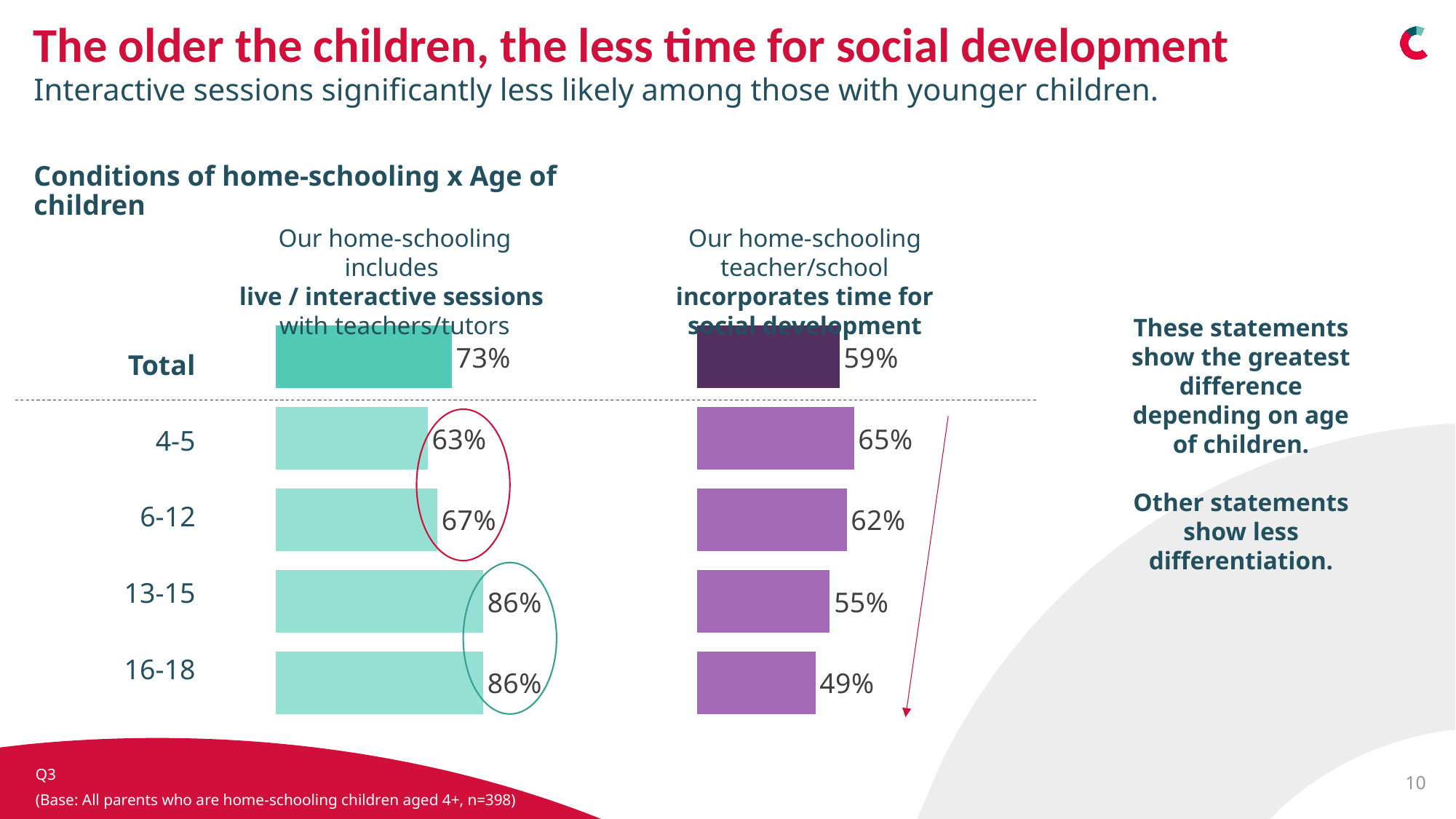
In the left chart (live / interactive sessions with teachers/tutors), which age group has the lowest value? 4-5 In the right chart (incorporates time for social development), what is the value for children aged 6-12? 62% In the left chart (live / interactive sessions with teachers/tutors), what is the value for Total? 73% In the right chart (incorporates time for social development), what is the difference between the values for ages 4-5 and ages 16-18? 16% In the right chart (incorporates time for social development), what is the value for children aged 16-18? 49% What type of chart is used on this slide? Bar chart How many age groups (excluding Total) are shown in each chart? 4 In the left chart (live / interactive sessions with teachers/tutors), what is the value for children aged 4-5? 63% In the right chart (incorporates time for social development), do the values rise or fall as the age groups get older from 4-5 to 16-18? Fall In the left chart (live / interactive sessions with teachers/tutors), what is the difference between the values for ages 13-15 and ages 6-12? 19% In the right chart (incorporates time for social development), which age group has the highest value? 4-5 In the right chart (incorporates time for social development), which is larger: the value for ages 13-15 or the value for ages 16-18? 13-15